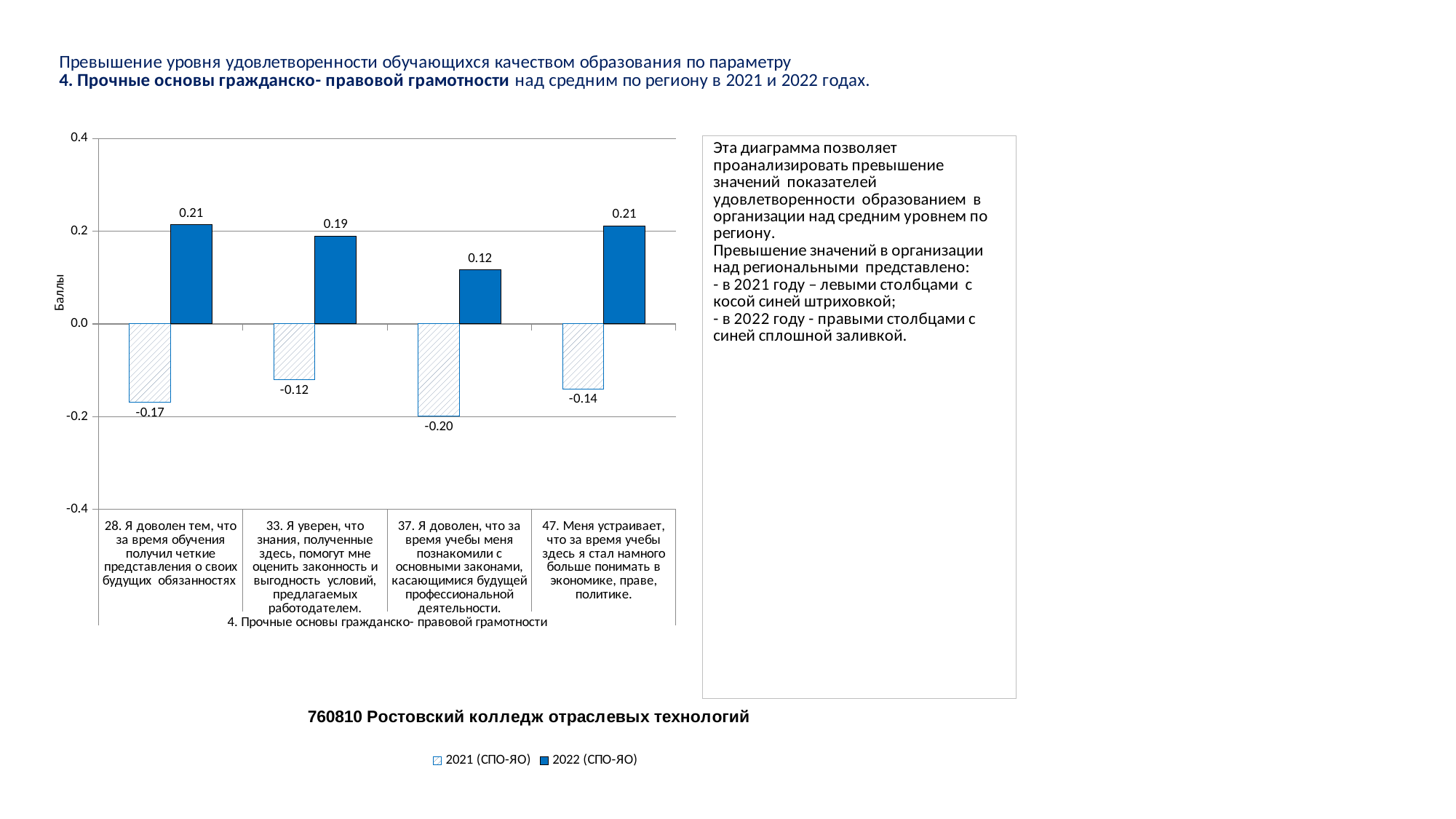
What is the 2021 (СПО-ЯО) value for question 33 ("Я уверен, что знания, полученные здесь, помогут мне оценить законность и выгодность условий...")? -0.12 Which is larger: the 2022 (СПО-ЯО) value for question 33 or for question 37? Question 33 How many questions (categories) are shown on the x axis of the chart? 4 Which question has the lowest 2022 (СПО-ЯО) value? 37. Я доволен, что за время учебы меня познакомили с основными законами, касающимися будущей профессиональной деятельности. What is the difference between the 2022 (СПО-ЯО) and 2021 (СПО-ЯО) values for question 28? 0.38 What is the 2022 (СПО-ЯО) value for question 28 ("Я доволен тем, что за время обучения получил четкие представления о своих будущих обязанностях")? 0.21 How many series does the chart legend list? 2 Which question has the highest 2021 (СПО-ЯО) value? 33. Я уверен, что знания, полученные здесь, помогут мне оценить законность и выгодность условий, предлагаемых работодателем. What is the difference between the 2022 (СПО-ЯО) values for question 33 and question 37? 0.07 What is the 2021 (СПО-ЯО) value for question 37 ("Я доволен, что за время учебы меня познакомили с основными законами...")? -0.20 Which question has the lowest 2021 (СПО-ЯО) value? 37. Я доволен, что за время учебы меня познакомили с основными законами, касающимися будущей профессиональной деятельности. What type of chart is shown on the slide? Bar chart